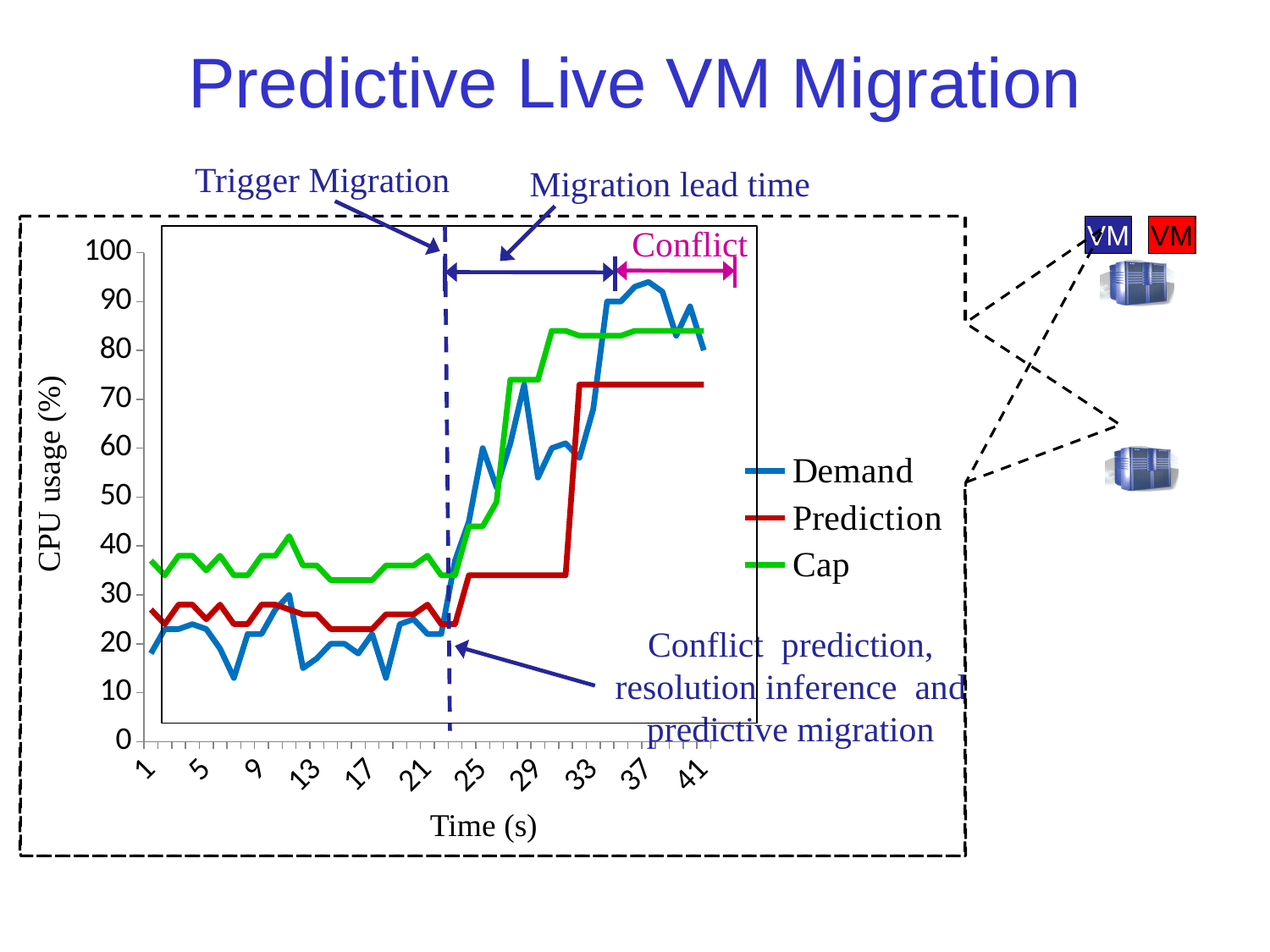
Is the value of the Cap series at time 41 greater or less than 80? greater What is the label of the chart's y axis? CPU usage (%) What kind of chart is shown on the slide? line chart At time 41, which series has the larger value, Cap or Prediction? Cap Is the value of the Prediction series at time 33 greater or less than 40? greater How many series does the chart's legend list? 3 Is the value of the Cap series at time 1 greater or less than 40? less Does the Prediction series rise or fall overall from time 1 to time 41? rise Which series has the highest value at time 5? Cap What are the three series named in the chart's legend? Demand, Prediction, Cap At time 37, which series has the larger value, Demand or Prediction? Demand